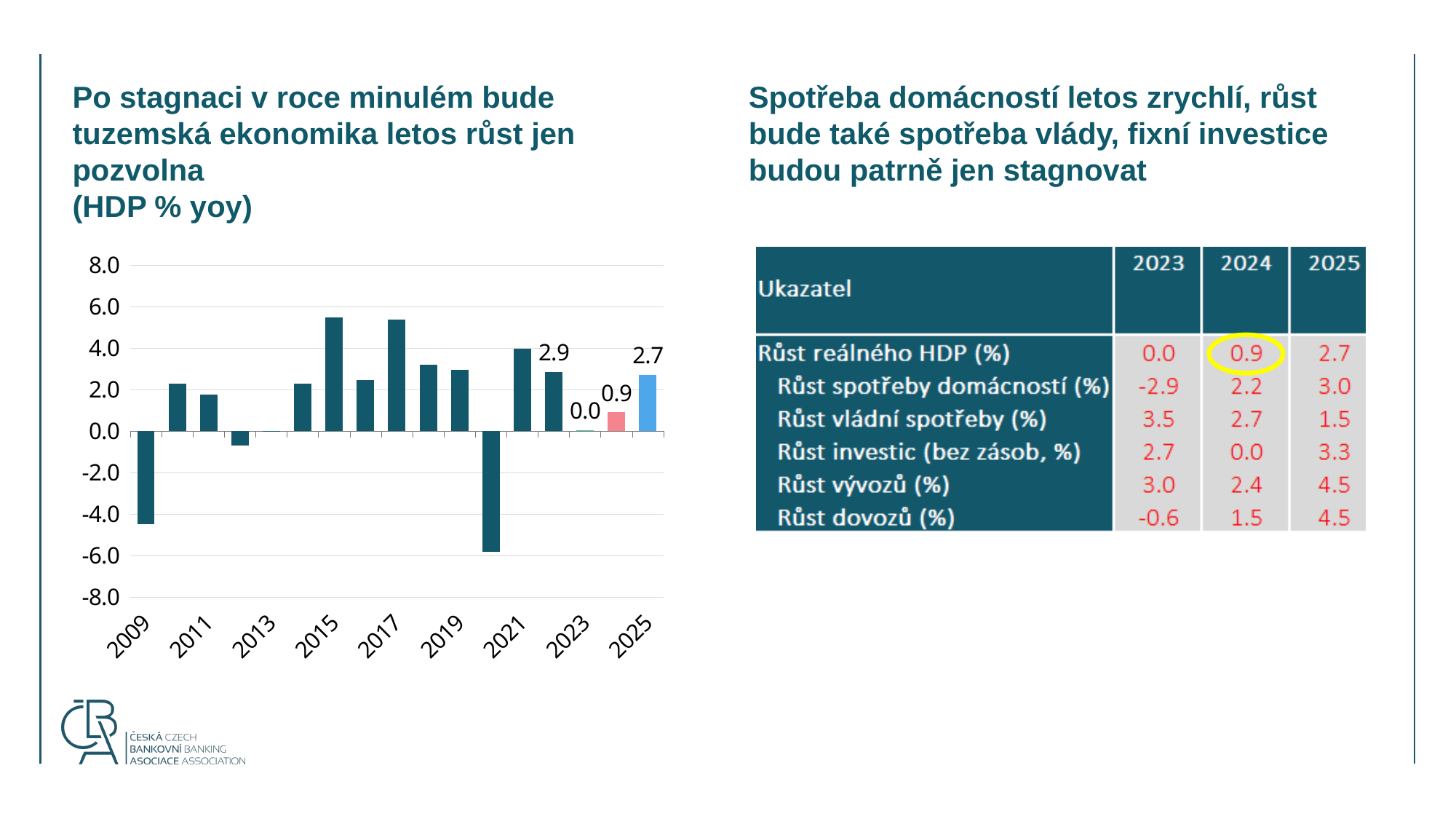
What is the value shown for 2024 in the HDP % yoy chart? 0.9 What is the value shown for 2022 in the HDP % yoy chart? 2.9 Which year has the larger value in the HDP % yoy chart, 2022 or 2025? 2022 What is the value shown for 2025 in the HDP % yoy chart? 2.7 Is the value for 2021 in the HDP % yoy chart greater or less than 2.0? greater Do the values in the HDP % yoy chart rise or fall from 2023 to 2025? rise Which year has the lowest value in the HDP % yoy chart? 2020 Is the value for 2009 in the HDP % yoy chart greater or less than -4.0? less What is the difference between the values for 2024 and 2023 in the HDP % yoy chart? 0.9 What is the value shown for 2023 in the HDP % yoy chart? 0.0 What kind of chart is shown on the slide? bar chart What is the difference between the values for 2022 and 2025 in the HDP % yoy chart? 0.2